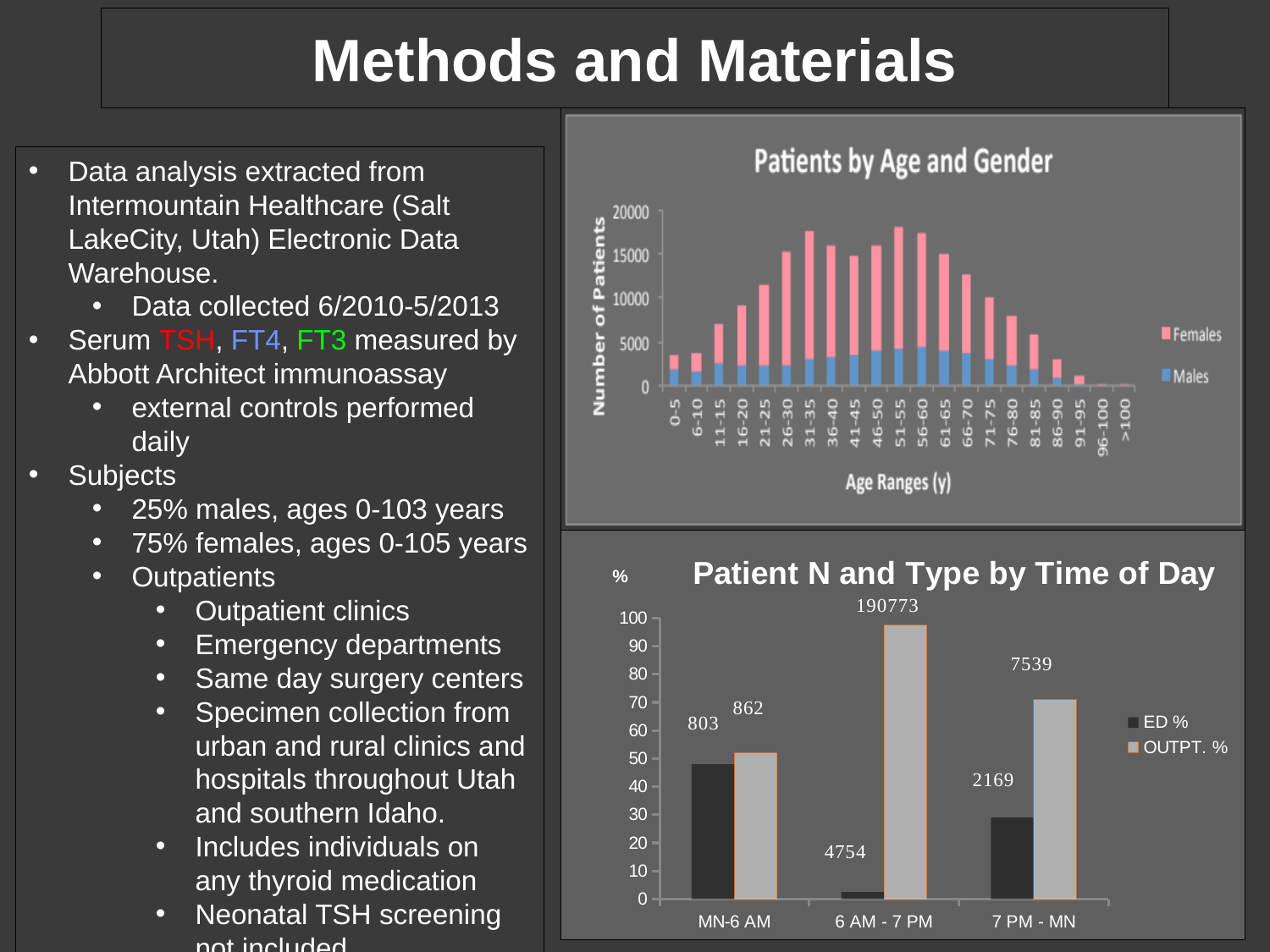
What type of chart is "Patient N and Type by Time of Day"? bar chart In "Patient N and Type by Time of Day", what data label is shown on the OUTPT. % bar for 6 AM - 7 PM? 190773 In "Patients by Age and Gender", which series is shown in pink? Females How many series does the legend of "Patients by Age and Gender" list? 2 In "Patient N and Type by Time of Day", is the ED % value for 6 AM - 7 PM greater or less than 10? less How many time-of-day categories are shown in "Patient N and Type by Time of Day"? 3 In "Patient N and Type by Time of Day", is the OUTPT. % value for 6 AM - 7 PM greater or less than 90? greater What type of chart is "Patients by Age and Gender"? bar chart In "Patient N and Type by Time of Day", what data label is shown on the ED % bar for 7 PM - MN? 2169 In "Patients by Age and Gender", is the total number of patients for the 0-5 age range greater or less than 5000? less How many age range categories are shown on the x axis of "Patients by Age and Gender"? 21